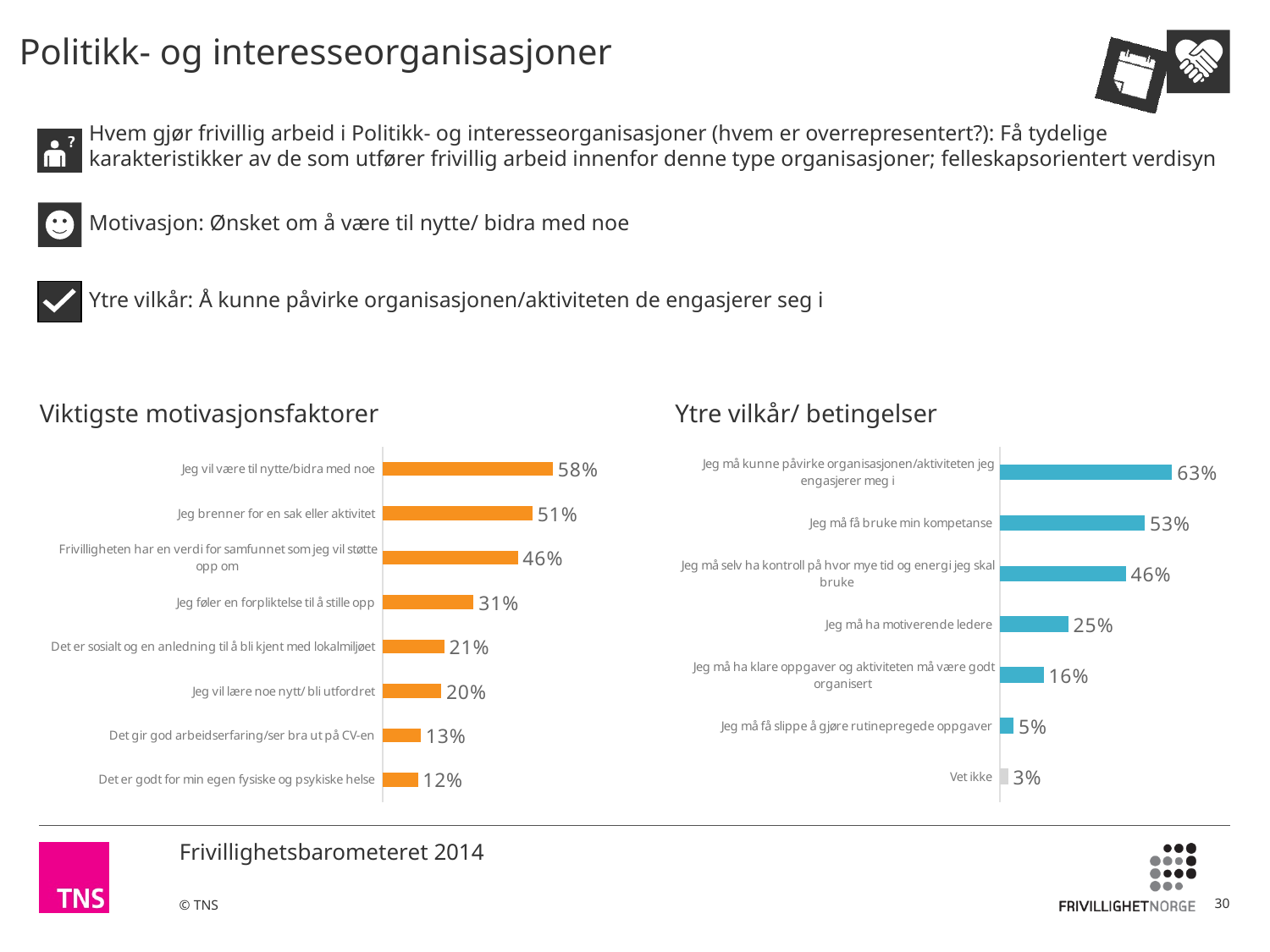
How many categories are shown in the 'Ytre vilkår/ betingelser' chart? 7 In the 'Viktigste motivasjonsfaktorer' chart, what is the value for 'Jeg vil være til nytte/bidra med noe'? 58% In the 'Viktigste motivasjonsfaktorer' chart, which category has the lowest value? Det er godt for min egen fysiske og psykiske helse In the 'Viktigste motivasjonsfaktorer' chart, what is the difference between 'Jeg brenner for en sak eller aktivitet' and 'Jeg føler en forpliktelse til å stille opp'? 20% In the 'Ytre vilkår/ betingelser' chart, which category has the highest value? Jeg må kunne påvirke organisasjonen/aktiviteten jeg engasjerer meg i In the 'Ytre vilkår/ betingelser' chart, what is the value for 'Jeg må få bruke min kompetanse'? 53% How many categories are shown in the 'Viktigste motivasjonsfaktorer' chart? 8 In the 'Ytre vilkår/ betingelser' chart, what is the difference between 'Jeg må ha motiverende ledere' and 'Jeg må få slippe å gjøre rutinepregede oppgaver'? 20% In the 'Ytre vilkår/ betingelser' chart, which is larger: 'Jeg må ha klare oppgaver og aktiviteten må være godt organisert' or 'Vet ikke'? Jeg må ha klare oppgaver og aktiviteten må være godt organisert In the 'Viktigste motivasjonsfaktorer' chart, which is larger: 'Det er sosialt og en anledning til å bli kjent med lokalmiljøet' or 'Det gir god arbeidserfaring/ser bra ut på CV-en'? Det er sosialt og en anledning til å bli kjent med lokalmiljøet What colour are the bars in the 'Viktigste motivasjonsfaktorer' chart? Orange What kind of chart is the 'Ytre vilkår/ betingelser' chart? Bar chart